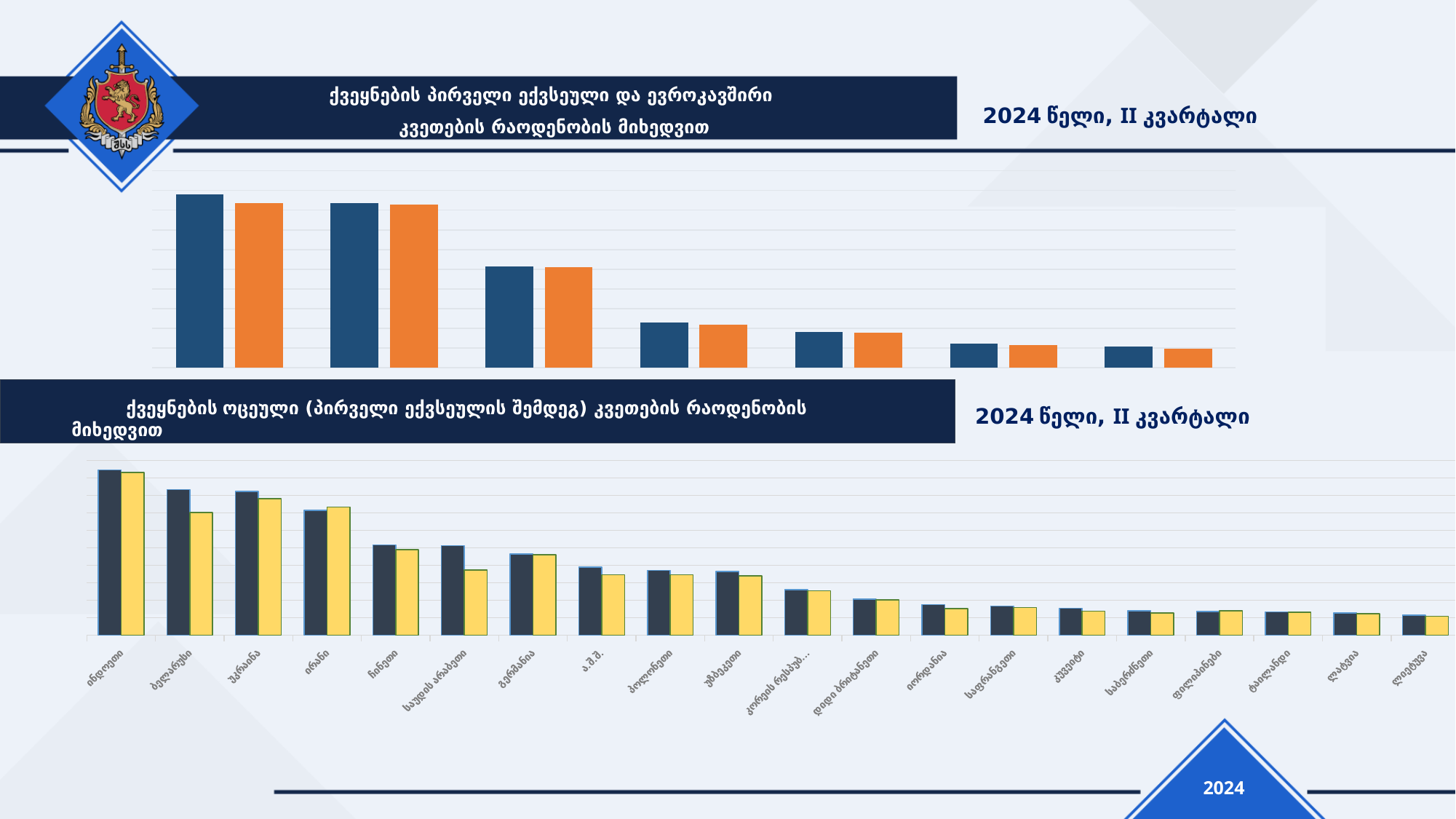
In the top chart, how many categories (pairs of bars) are plotted? 7 In the top chart, do the bar heights rise or fall from left to right? fall In the bottom chart, how many countries are plotted along the x axis? 20 What two colours are the bars in the top chart? blue and orange In the bottom chart, which has the taller dark bar: უკრაინა or ირანი? უკრაინა In the bottom chart, which country has the lowest bars? ლიეტუვა What kind of chart is the bottom chart on the slide? bar chart In the bottom chart, which country has the highest bars? ინდოეთი What kind of chart is the top chart on the slide? bar chart In the bottom chart, which has the taller dark bar: ჩინეთი or გერმანია? ჩინეთი In the bottom chart, do the bar heights generally rise or fall from left to right? fall In the bottom chart, which has the taller dark bar: ინდოეთი or ბელარუსი? ინდოეთი